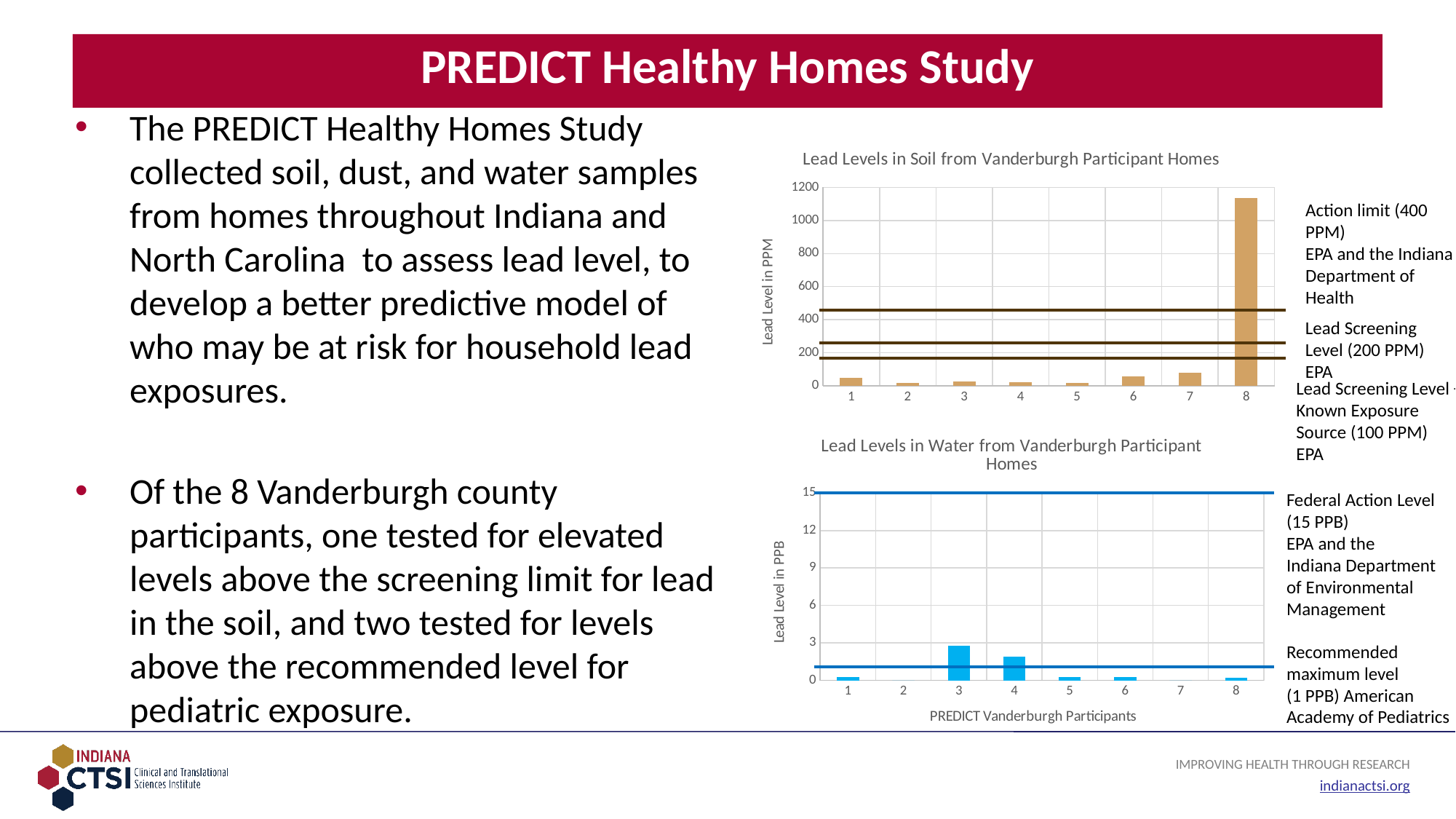
In the 'Lead Levels in Water from Vanderburgh Participant Homes' chart, which participant has the highest lead level? 3 In the 'Lead Levels in Water from Vanderburgh Participant Homes' chart, is the value for participant 3 greater or less than 3? less In the 'Lead Levels in Soil from Vanderburgh Participant Homes' chart, which has the larger value, participant 7 or participant 6? participant 7 In the 'Lead Levels in Water from Vanderburgh Participant Homes' chart, which has the larger value, participant 3 or participant 4? participant 3 In the 'Lead Levels in Water from Vanderburgh Participant Homes' chart, is the value for participant 4 greater or less than 1? greater What is the y-axis label of the 'Lead Levels in Soil from Vanderburgh Participant Homes' chart? Lead Level in PPM In the 'Lead Levels in Soil from Vanderburgh Participant Homes' chart, which participant has the highest lead level? 8 What is the x-axis label of the 'Lead Levels in Water from Vanderburgh Participant Homes' chart? PREDICT Vanderburgh Participants What kind of chart is the 'Lead Levels in Soil from Vanderburgh Participant Homes' chart? bar chart In the 'Lead Levels in Soil from Vanderburgh Participant Homes' chart, is the value for participant 1 greater or less than 200? less How many participants are shown on the x axis of the 'Lead Levels in Soil from Vanderburgh Participant Homes' chart? 8